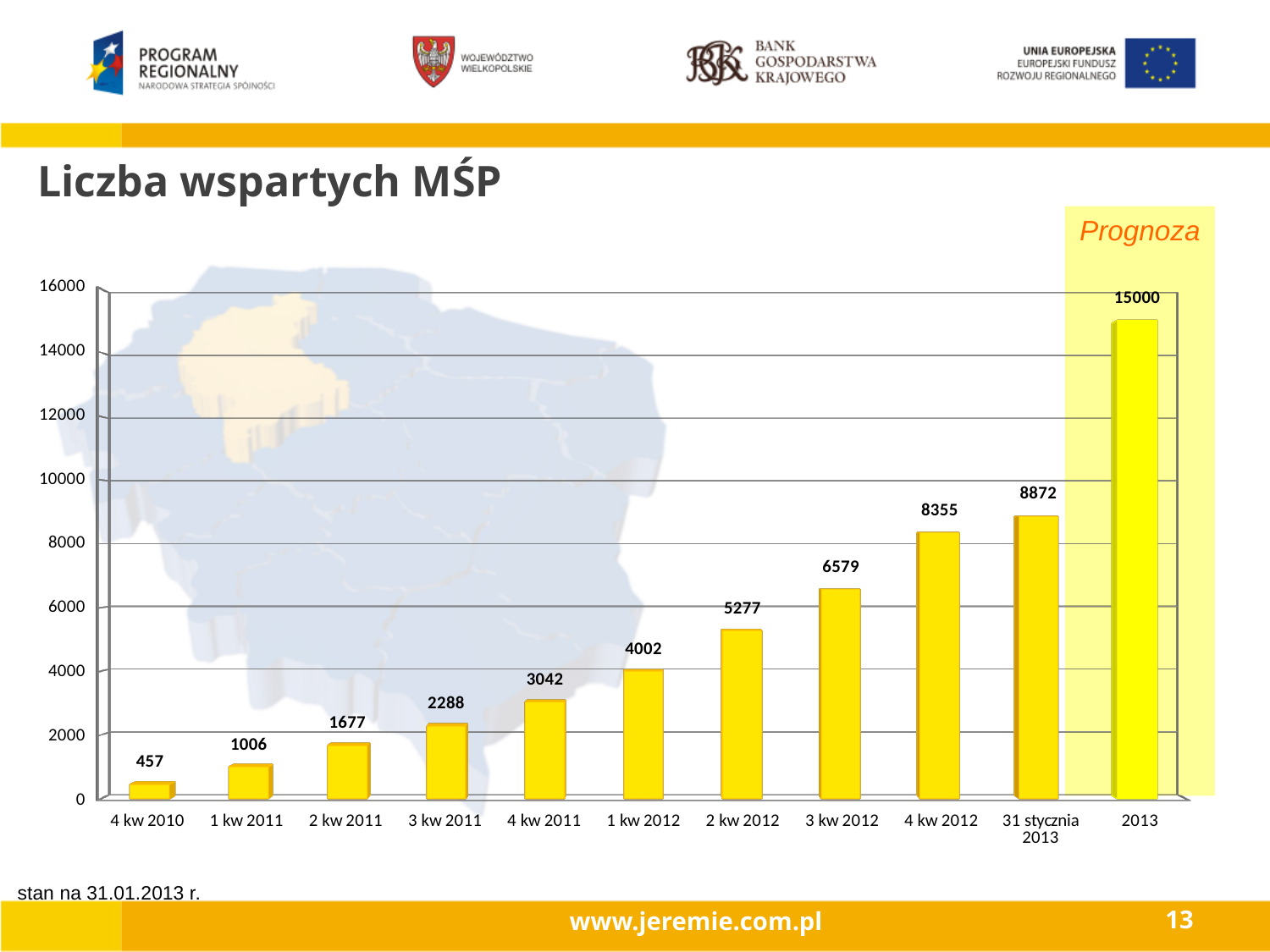
What kind of chart is shown on the slide? bar chart Which category has the highest value? 2013 Is the value for 3 kw 2012 greater or less than 6000? greater How many categories are shown on the x axis? 11 Which category has the lowest value? 4 kw 2010 What is the difference between the values for 4 kw 2012 and 3 kw 2012? 1776 What is the value for 4 kw 2011? 3042 Which is larger, the value for 1 kw 2011 or the value for 2 kw 2011? 2 kw 2011 What is the forecast (Prognoza) value for 2013? 15000 What is the value for 31 stycznia 2013? 8872 What is the difference between the values for 2 kw 2012 and 1 kw 2012? 1275 Do the values rise or fall along the x axis? rise